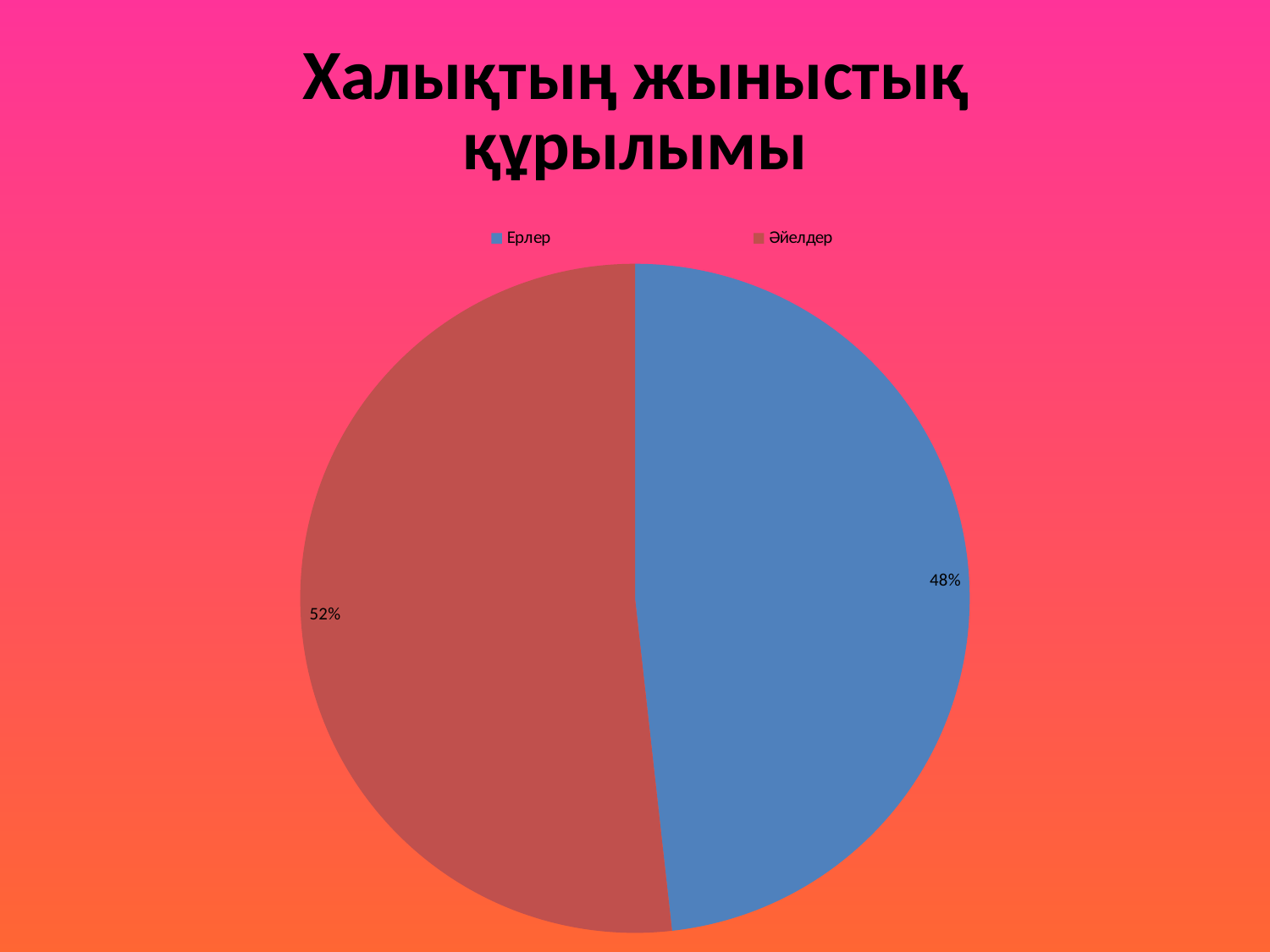
How many slices does the pie chart have? 2 How many entries does the legend list? 2 Which is larger, the Ерлер slice or the Әйелдер slice? Әйелдер What share of the pie does Әйелдер represent? 52% What colour is the Ерлер slice? Blue Which category has the smallest slice of the pie? Ерлер What share of the pie does Ерлер represent? 48% Which category has the largest slice of the pie? Әйелдер What is the title of the chart? Халықтың жыныстық құрылымы What kind of chart is shown on the slide? Pie chart What is the difference in percentage points between the Әйелдер and Ерлер slices? 4